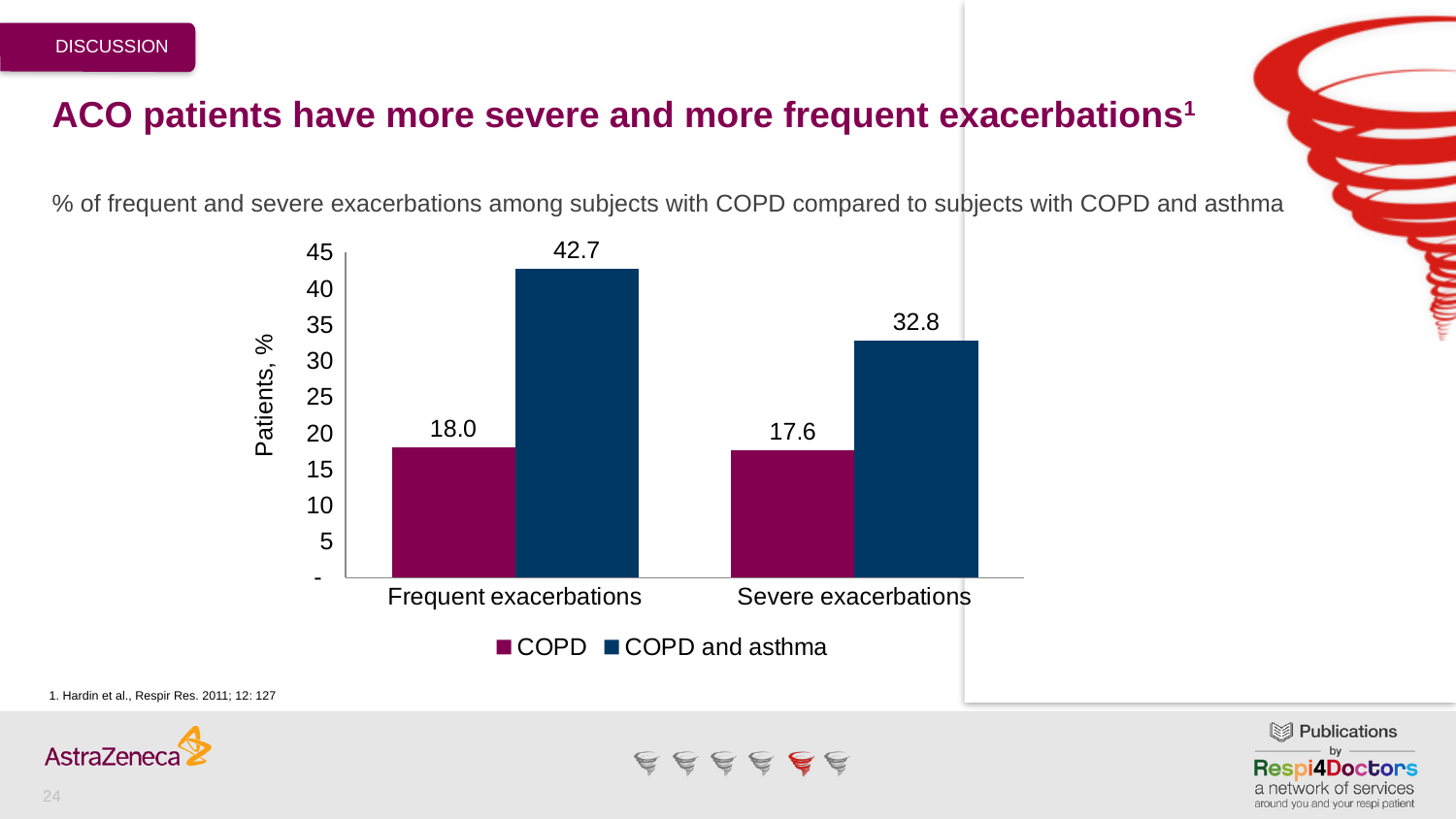
What is the value for COPD in the Frequent exacerbations category? 18.0 What kind of chart is shown on the slide? Bar chart What is the difference between COPD and asthma and COPD in the Frequent exacerbations category? 24.7 What is the difference between COPD and asthma and COPD in the Severe exacerbations category? 15.2 Which bar has the highest value on the chart? COPD and asthma, Frequent exacerbations How many series does the legend list? 2 Which bar has the lowest value on the chart? COPD, Severe exacerbations What is the label of the y axis? Patients, % What is the value for COPD in the Severe exacerbations category? 17.6 What is the value for COPD and asthma in the Frequent exacerbations category? 42.7 What is the value for COPD and asthma in the Severe exacerbations category? 32.8 Which is larger in the Severe exacerbations category: COPD or COPD and asthma? COPD and asthma